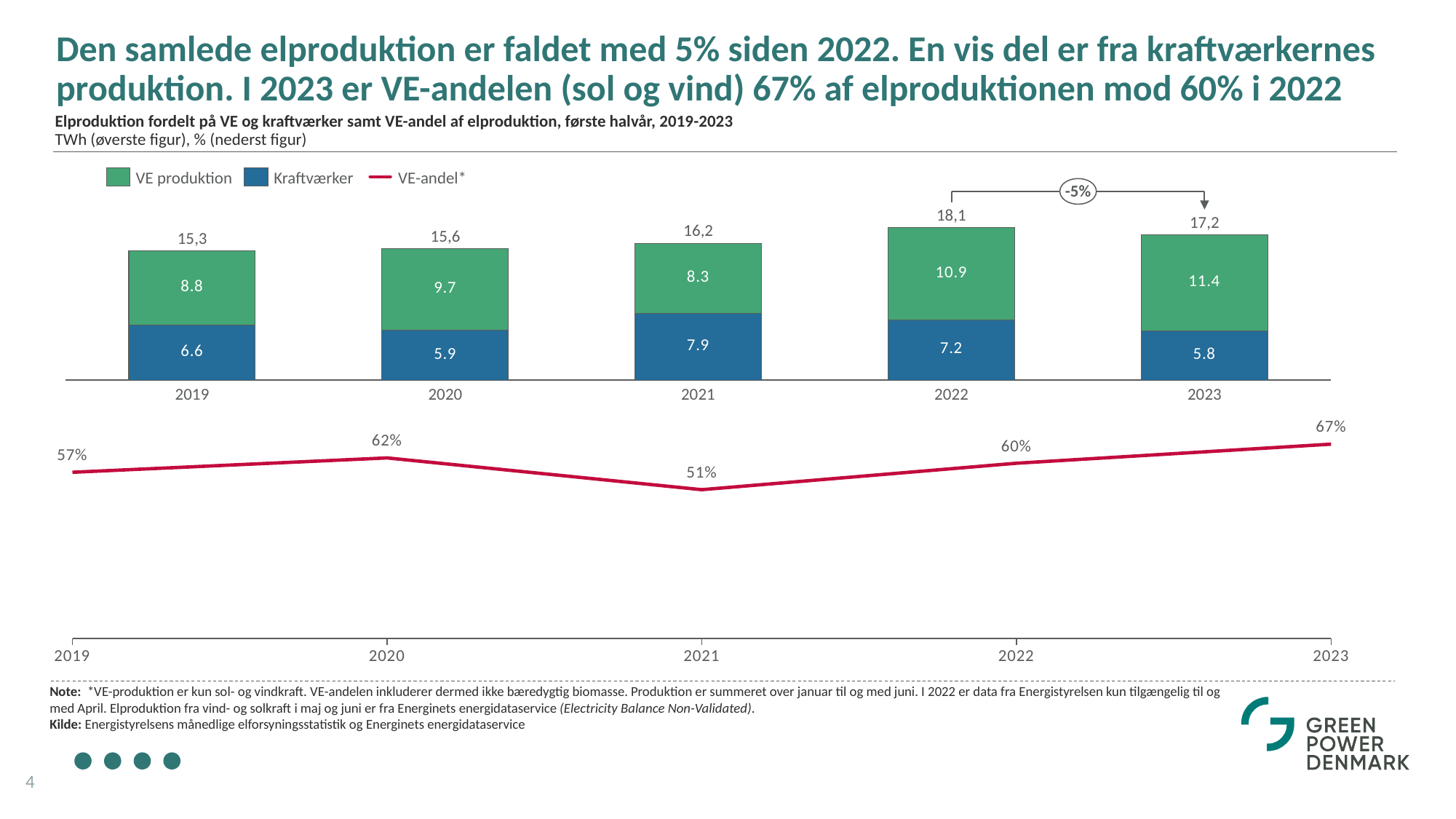
In the top chart, what is the Kraftværker value for 2021? 7.9 In the bottom chart, which year has the highest VE-andel? 2023 In the top chart, what is the VE produktion value for 2023? 11.4 In the top chart, which is larger: the Kraftværker value for 2019 or for 2020? 2019 In the top chart, what is the difference between the VE produktion values for 2023 and 2022? 0.5 In the bottom chart, what is the difference between the VE-andel for 2023 and 2022? 7% In the bottom chart, what is the VE-andel for 2021? 51% What kind of chart is the top chart? Stacked bar chart In the top chart, which year has the highest Kraftværker value? 2021 How many series does the legend on the slide list? 3 In the top chart, which year has the lowest VE produktion value? 2021 In the top chart, what is the total printed above the 2022 bar? 18,1